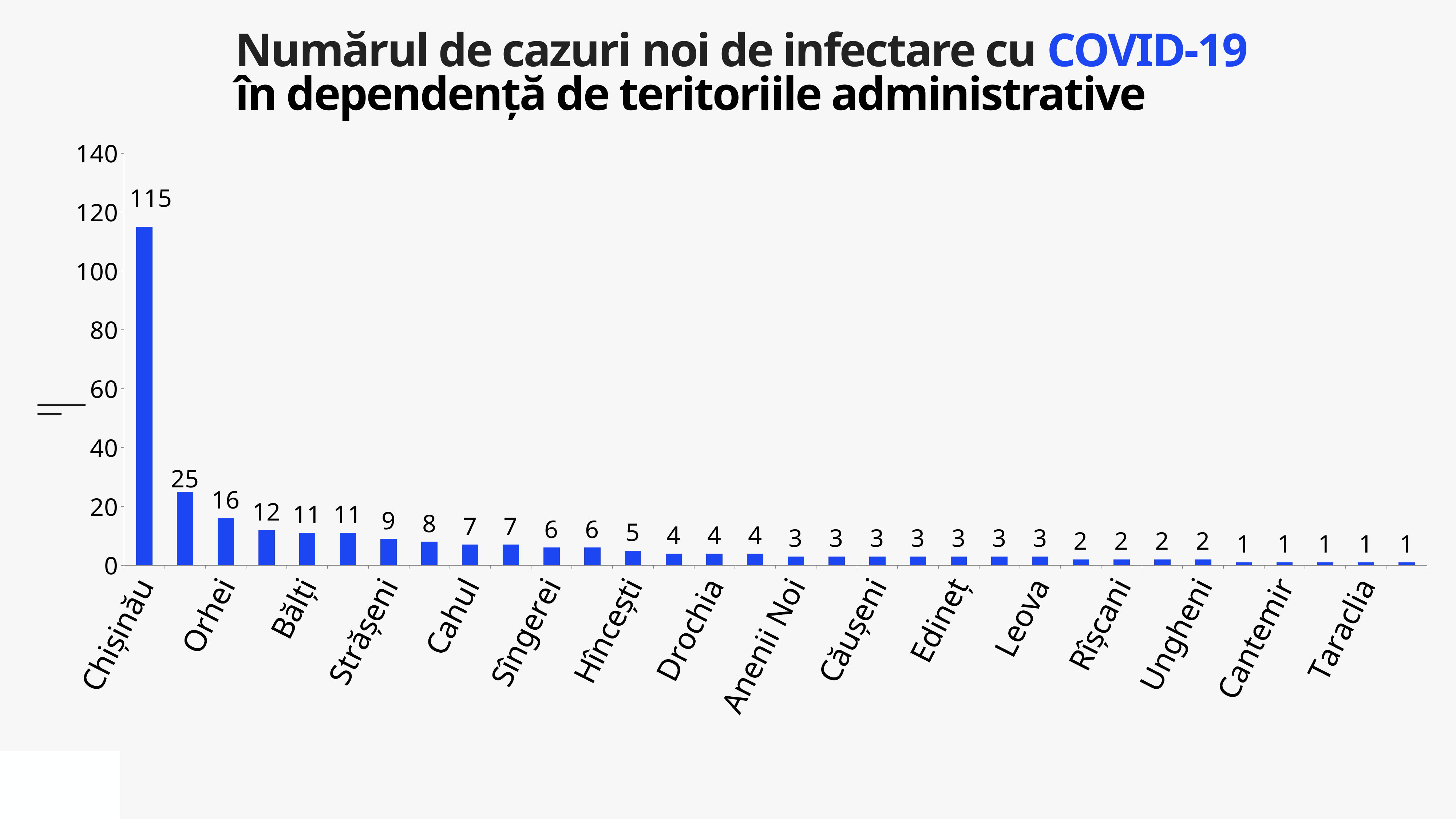
What is the lowest value shown on the chart? 1 Do the values rise or fall from left to right along the x axis? fall How many new COVID-19 cases are shown for Chișinău? 115 What is the highest tick value shown on the vertical axis? 140 What is the second-highest value shown on the chart? 25 What kind of chart is shown on the slide? bar chart Is the value for Chișinău greater or less than 100? greater How many bars are plotted on the chart? 32 Which word in the chart title is shown in blue? COVID-19 Which territory has the highest number of new COVID-19 cases? Chișinău What is the difference between the highest bar (115) and the second-highest bar (25)? 90 How many bars have a value of 1? 5